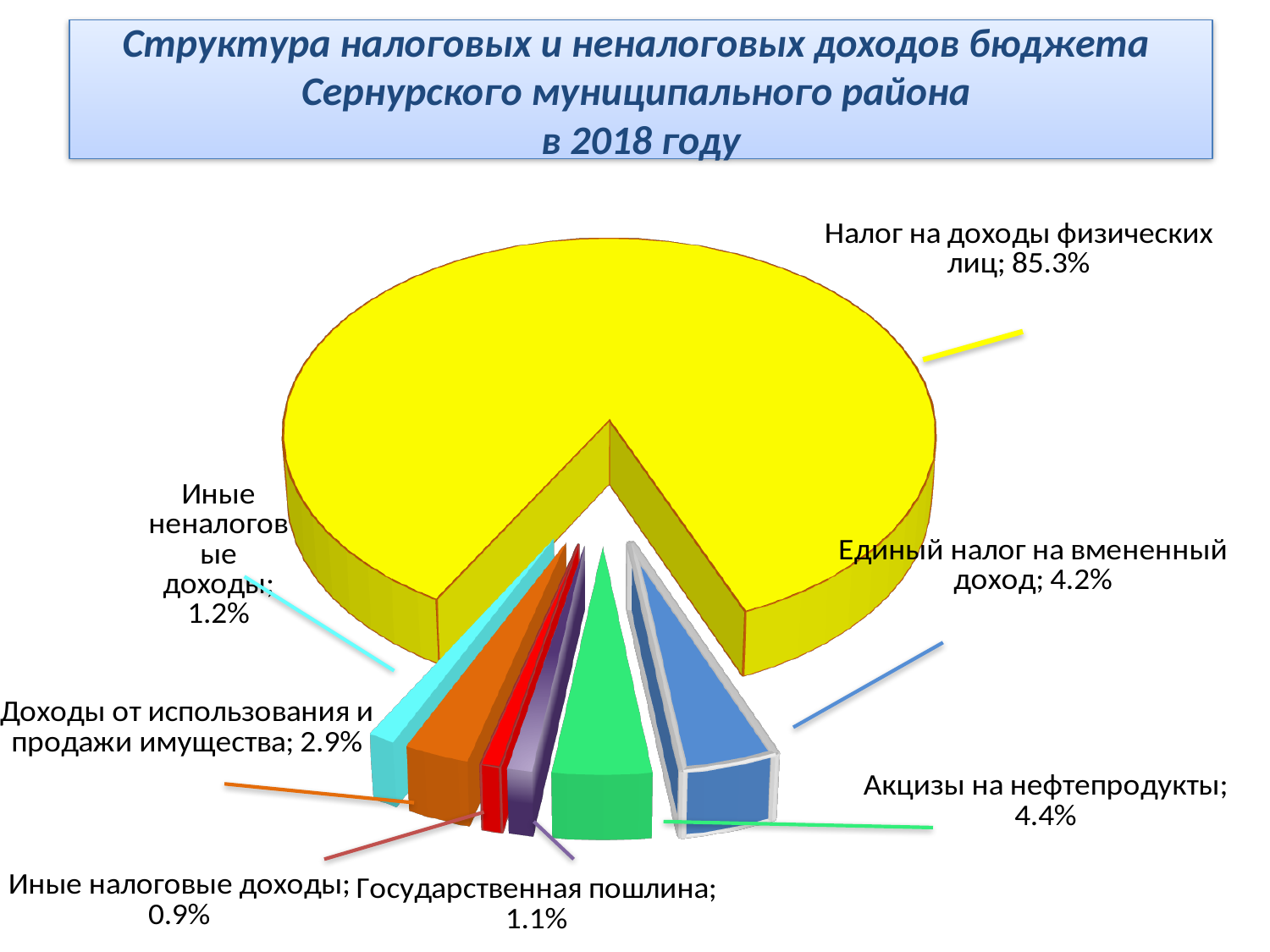
What is the difference between the shares of "Акцизы на нефтепродукты" and "Единый налог на вмененный доход"? 0.2% What is the value shown for "Государственная пошлина"? 1.1% How many slices does the pie chart have? 7 What is the value shown for "Доходы от использования и продажи имущества"? 2.9% What share of the pie is labelled for "Налог на доходы физических лиц"? 85.3% Which year does the chart title refer to? 2018 Which category has the largest share of the pie? Налог на доходы физических лиц What kind of chart is shown on the slide? Pie chart Which is larger: "Иные неналоговые доходы" or "Иные налоговые доходы"? Иные неналоговые доходы What is the value shown for "Акцизы на нефтепродукты"? 4.4% What is the value shown for "Единый налог на вмененный доход"? 4.2% Which category has the smallest share of the pie? Иные налоговые доходы